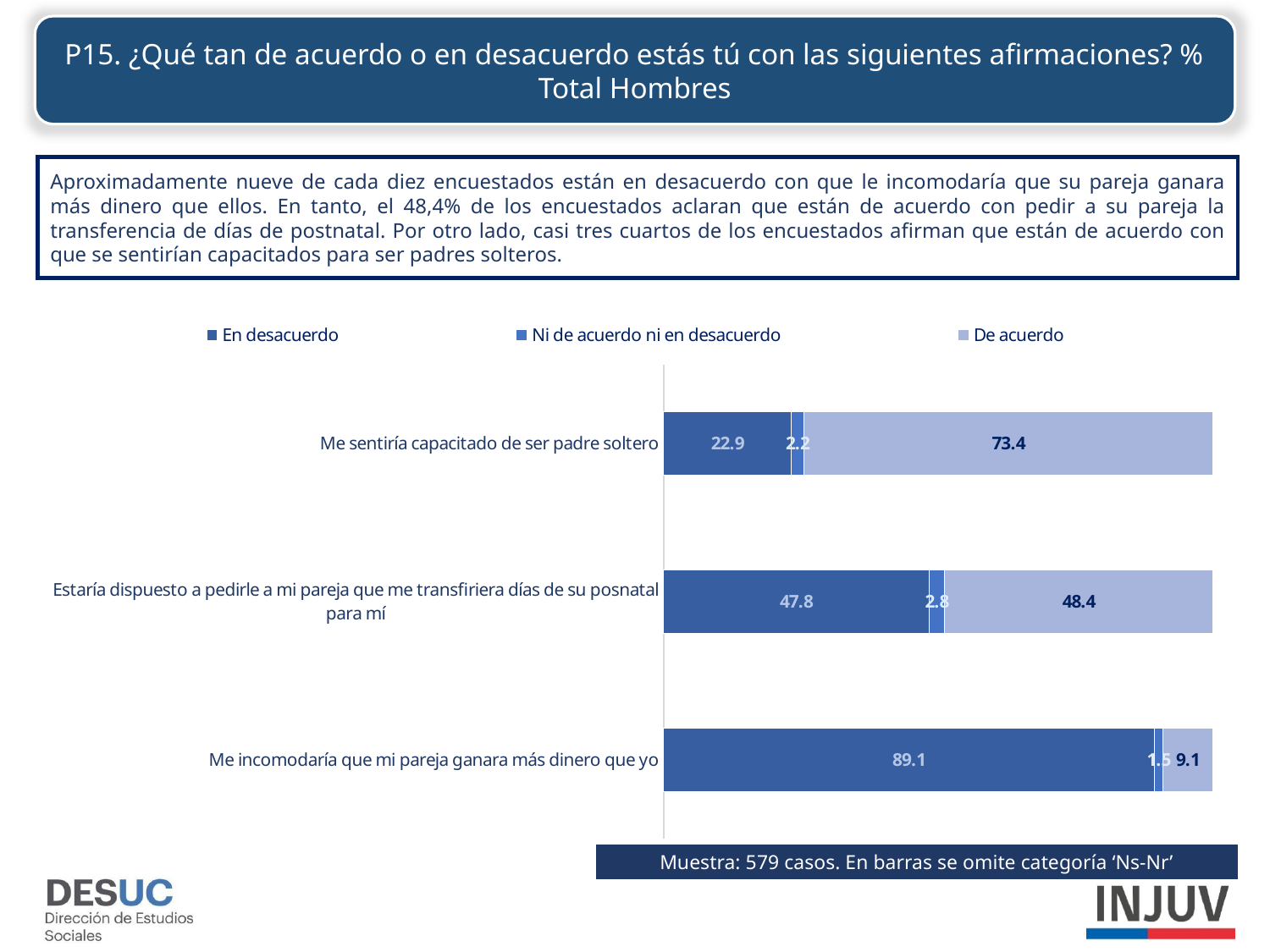
What is the total of the three printed values in the bar for 'Estaría dispuesto a pedirle a mi pareja que me transfiriera días de su posnatal para mí'? 99.0 What is the difference between the 'De acuerdo' and 'En desacuerdo' values for 'Me sentiría capacitado de ser padre soltero'? 50.5 For 'Me sentiría capacitado de ser padre soltero', which is larger: 'En desacuerdo' or 'De acuerdo'? De acuerdo What is the difference between the 'En desacuerdo' and 'De acuerdo' values for 'Me incomodaría que mi pareja ganara más dinero que yo'? 80.0 How many series does the legend list? 3 What kind of chart is shown on the slide? Stacked bar chart What is the 'De acuerdo' value for 'Me sentiría capacitado de ser padre soltero'? 73.4 How many statements (categories) are shown in the chart? 3 Which statement has the highest 'En desacuerdo' value? Me incomodaría que mi pareja ganara más dinero que yo What is the 'En desacuerdo' value for 'Me incomodaría que mi pareja ganara más dinero que yo'? 89.1 What is the 'Ni de acuerdo ni en desacuerdo' value for 'Estaría dispuesto a pedirle a mi pareja que me transfiriera días de su posnatal para mí'? 2.8 Which statement has the lowest 'De acuerdo' value? Me incomodaría que mi pareja ganara más dinero que yo